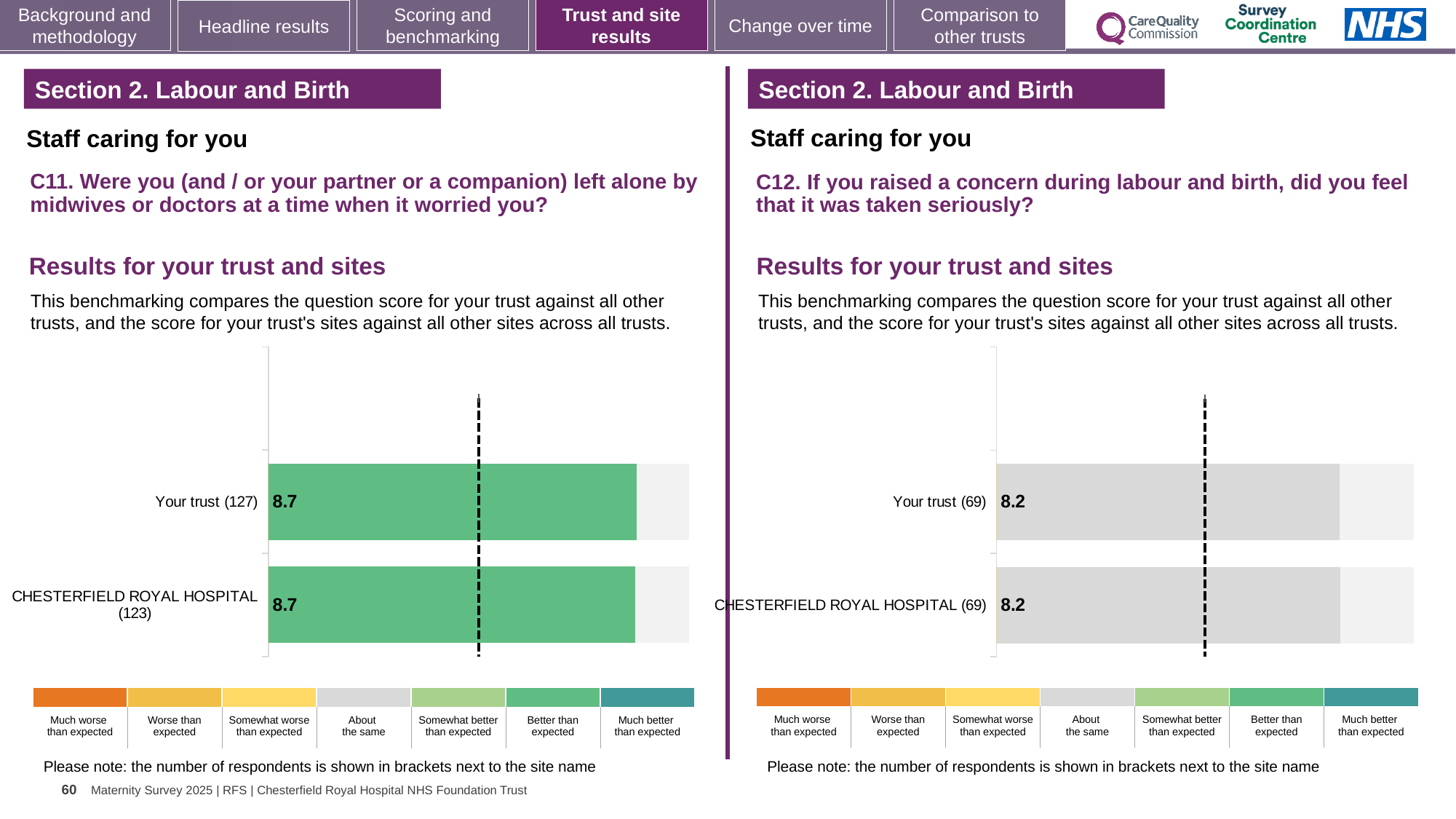
In the C11 chart on the left, what is the score for CHESTERFIELD ROYAL HOSPITAL (123)? 8.7 In the C12 chart on the right, what is the score for Your trust (69)? 8.2 How many bars are plotted in the C11 chart on the left? 2 How many bars are plotted in the C12 chart on the right? 2 In the C12 chart on the right, what is the difference between the score for Your trust and the score for CHESTERFIELD ROYAL HOSPITAL? 0 In the C12 chart on the right, which benchmark category does the grey colour of the bars correspond to in the key? About the same What type of chart is used for the C11 results on the left? Bar chart In the C11 chart on the left, what is the score for Your trust (127)? 8.7 In the C12 chart on the right, what is the score for CHESTERFIELD ROYAL HOSPITAL (69)? 8.2 In the C11 chart on the left, what is the difference between the score for Your trust and the score for CHESTERFIELD ROYAL HOSPITAL? 0 In the C11 chart on the left, which benchmark category does the green colour of the bars correspond to in the key? Better than expected In the C11 chart on the left, how many respondents are shown in brackets for Your trust? 127